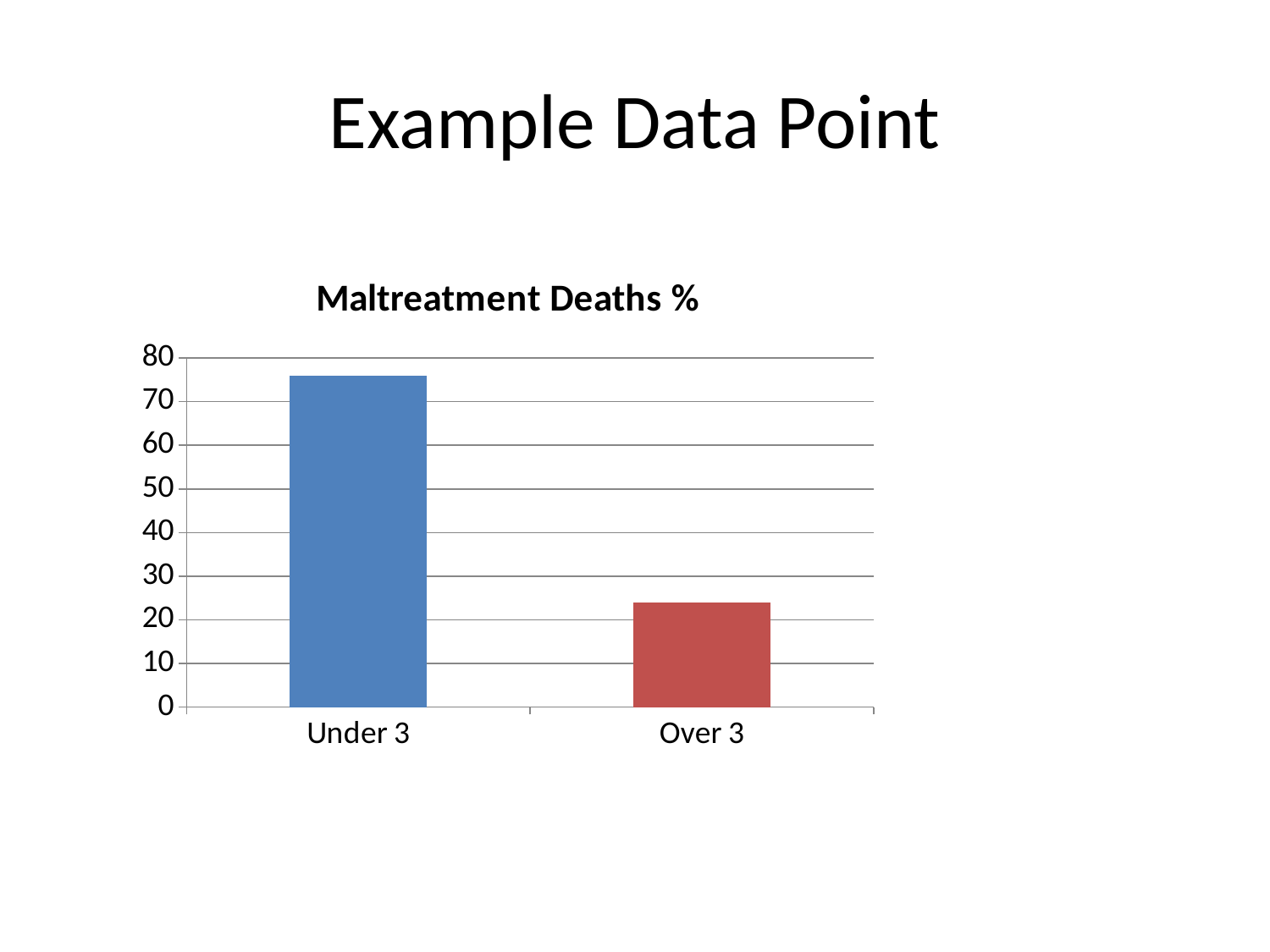
What type of chart is shown on the slide? Bar chart What is the title of the chart? Maltreatment Deaths % Which is larger, the value for Under 3 or the value for Over 3? Under 3 Which category has the highest value in the chart? Under 3 Is the value for Over 3 greater or less than 20? greater Is the value for Under 3 greater or less than 70? greater Is the value for Under 3 greater or less than 80? less How many categories are shown on the x axis of the chart? 2 Do the values rise or fall from Under 3 to Over 3 along the x axis? Fall Which category has the lowest value in the chart? Over 3 What colour is the bar for Over 3? Red